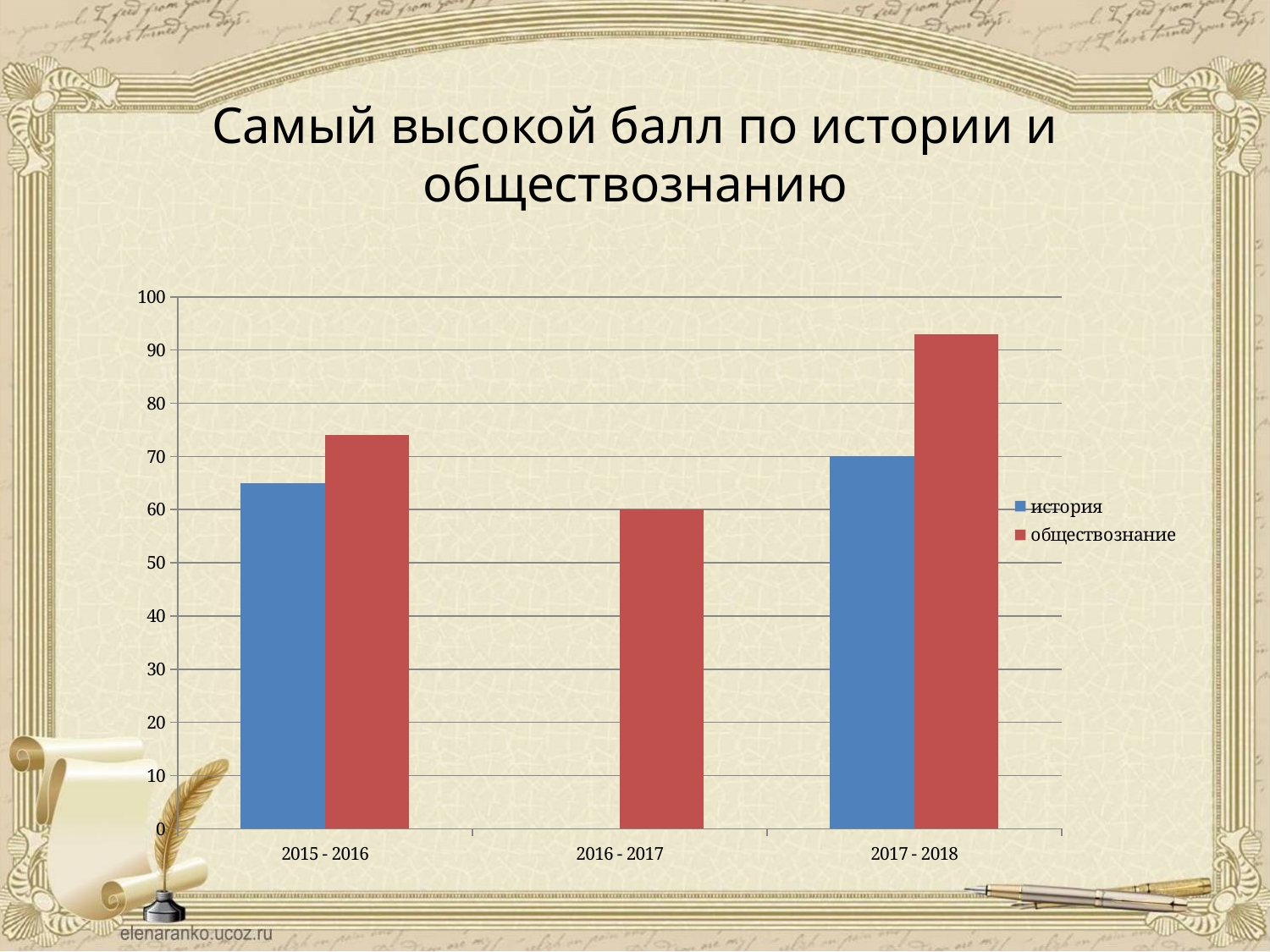
How many categories are shown on the x axis? 3 What is the value for обществознание in 2016 - 2017? 60 What kind of chart is shown on the slide? bar chart Is the value for обществознание in 2015 - 2016 greater or less than 80? less In which year is the value for обществознание lowest? 2016 - 2017 What is the title of the chart? Самый высокой балл по истории и обществознанию In which year is the value for обществознание highest? 2017 - 2018 In 2017 - 2018, which is larger: история or обществознание? обществознание How many series does the legend list? 2 Is the value for обществознание in 2017 - 2018 greater or less than 90? greater Is the value for история in 2015 - 2016 greater or less than 60? greater What is the value for история in 2017 - 2018? 70